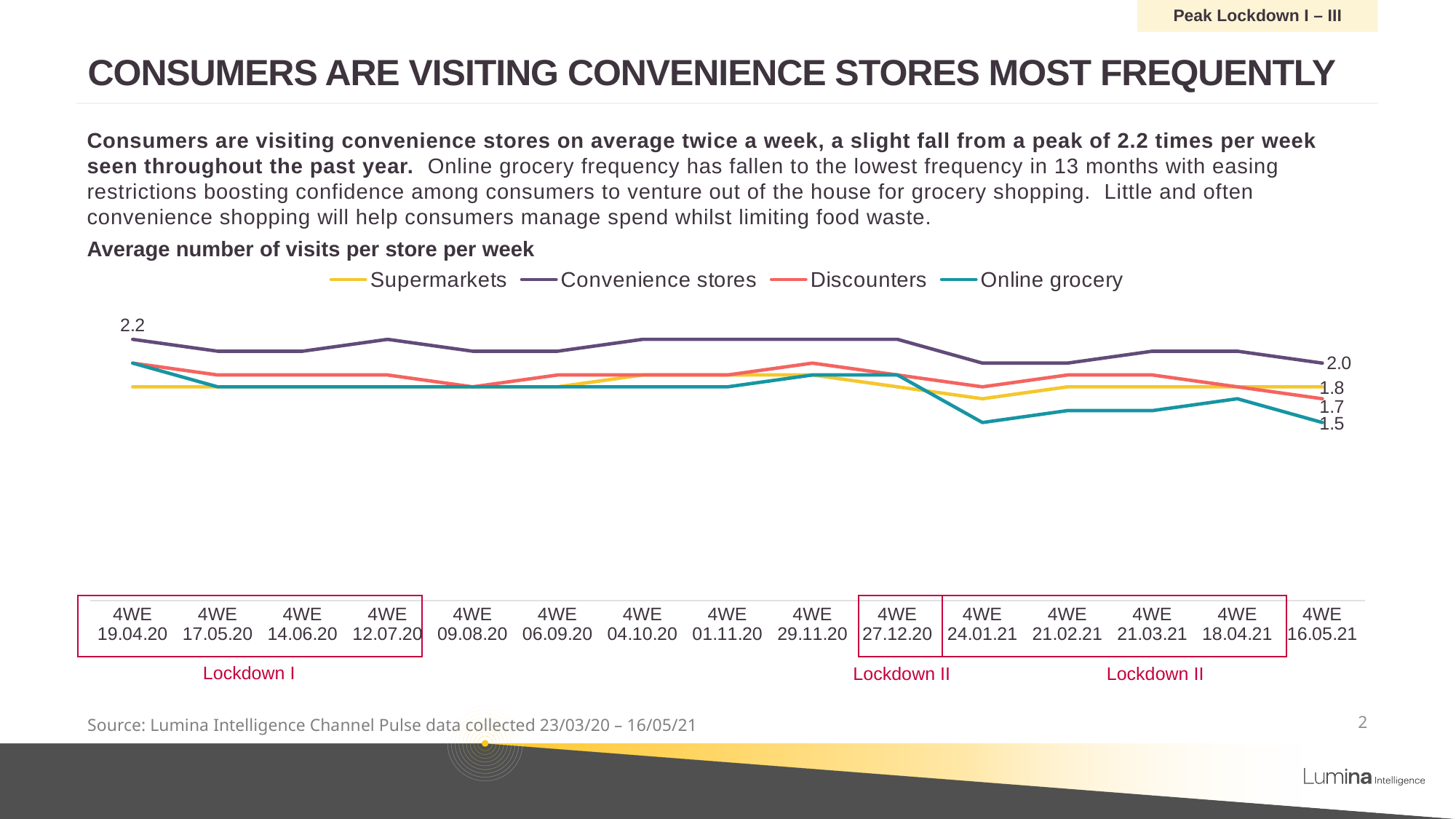
What is the value for Supermarkets at 4WE 16.05.21? 1.8 What is the value for Convenience stores at 4WE 19.04.20? 2.2 What type of chart is shown on the slide? Line chart How many time points (4WE periods) are plotted along the x axis? 15 What is the difference between the Convenience stores value and the Online grocery value at 4WE 16.05.21? 0.5 What is the value for Online grocery at 4WE 16.05.21? 1.5 What is the value for Convenience stores at 4WE 16.05.21? 2.0 What is the title of the chart? Average number of visits per store per week What is the value for Discounters at 4WE 16.05.21? 1.7 How many series does the chart legend list? 4 Which series has the lowest value at 4WE 16.05.21? Online grocery Which series has the highest value at 4WE 16.05.21? Convenience stores